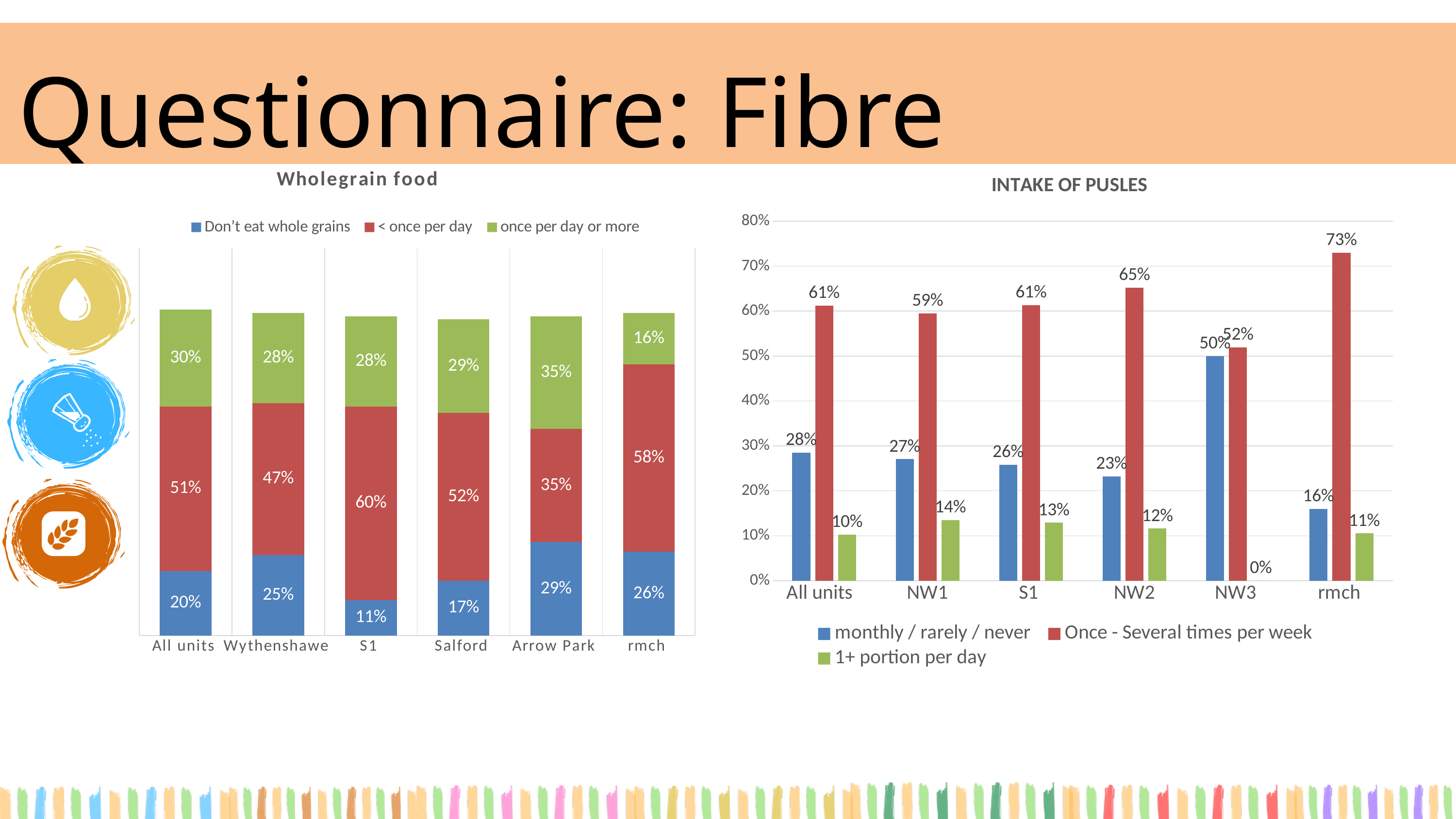
In the 'Wholegrain food' chart, which unit has the lowest 'once per day or more' value? rmch In the 'Wholegrain food' chart, what is the total of the stacked bar for Wythenshawe? 100% In the 'Wholegrain food' chart, which unit has the highest 'Don't eat whole grains' value? Arrow Park In the 'Wholegrain food' chart, what is the difference between the '< once per day' values for S1 and Arrow Park? 25% What kind of chart is the 'Wholegrain food' chart? Stacked bar chart In the 'INTAKE OF PUSLES' chart, what is the 'Once - Several times per week' value for rmch? 73% In the 'INTAKE OF PUSLES' chart, is the 'Once - Several times per week' value for NW2 larger or smaller than that for NW1? Larger In the 'INTAKE OF PUSLES' chart, which unit has the lowest '1+ portion per day' value? NW3 In the 'Wholegrain food' chart, what percentage of S1 respondents eat whole grains less than once per day? 60% In the 'Wholegrain food' chart, what is the value for 'Don't eat whole grains' at Arrow Park? 29% In the 'INTAKE OF PUSLES' chart, which unit has the highest 'monthly / rarely / never' value? NW3 How many series does the legend of the 'INTAKE OF PUSLES' chart list? 3